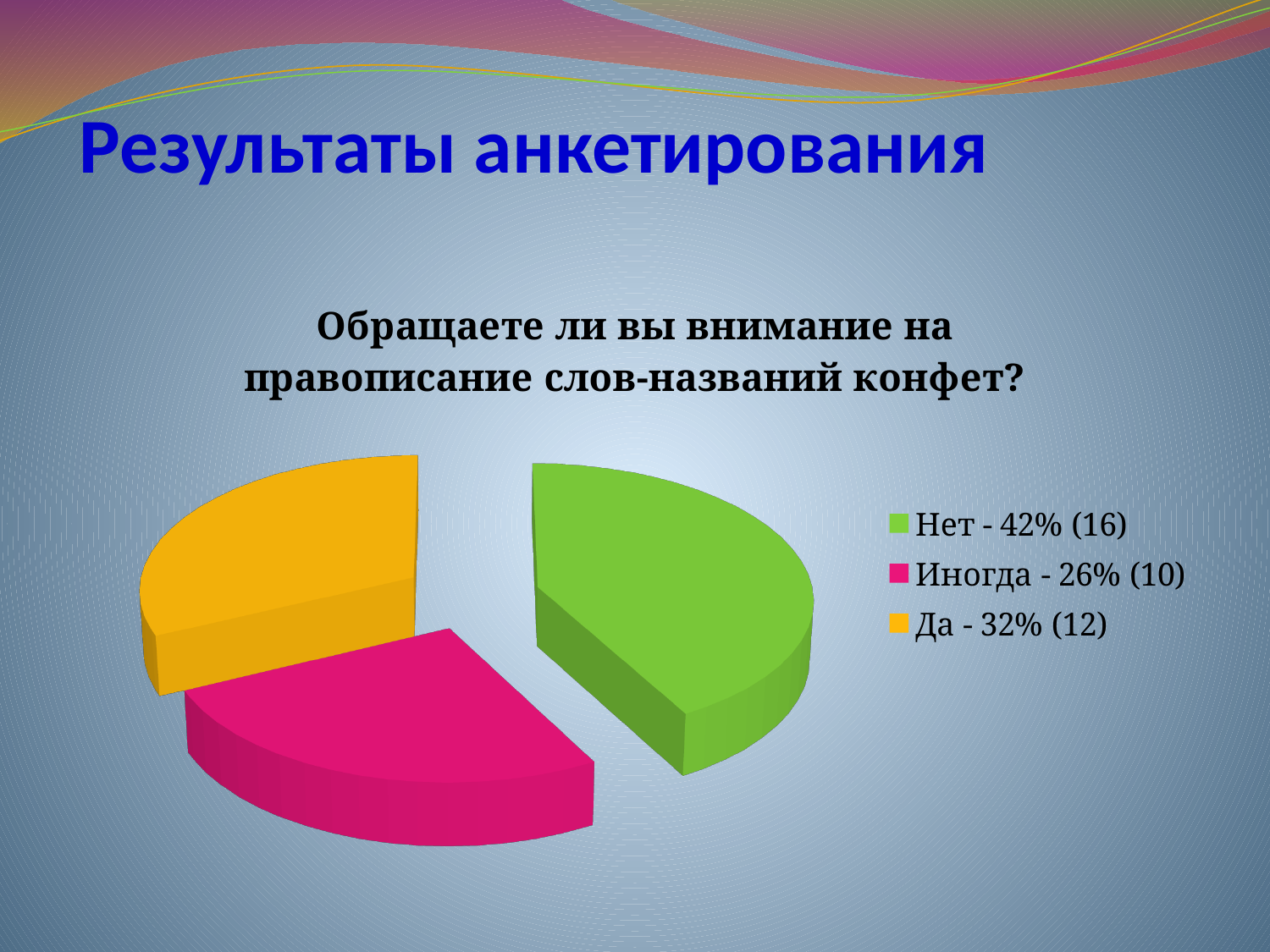
What is the total number of respondents across all three answers? 38 What kind of chart is shown on the slide? pie chart Which has more respondents, "Да" or "Иногда"? Да What percentage of respondents answered "Нет"? 42% Which answer has the smallest share of the pie? Иногда What is the title of the chart? Обращаете ли вы внимание на правописание слов-названий конфет? What is the difference in percentage points between "Нет" and "Да"? 10 How many slices does the pie chart have? 3 What percentage of respondents answered "Да"? 32% Which answer has the largest share of the pie? Нет Which colour represents the "Иногда" slice? pink How many respondents answered "Иногда"? 10